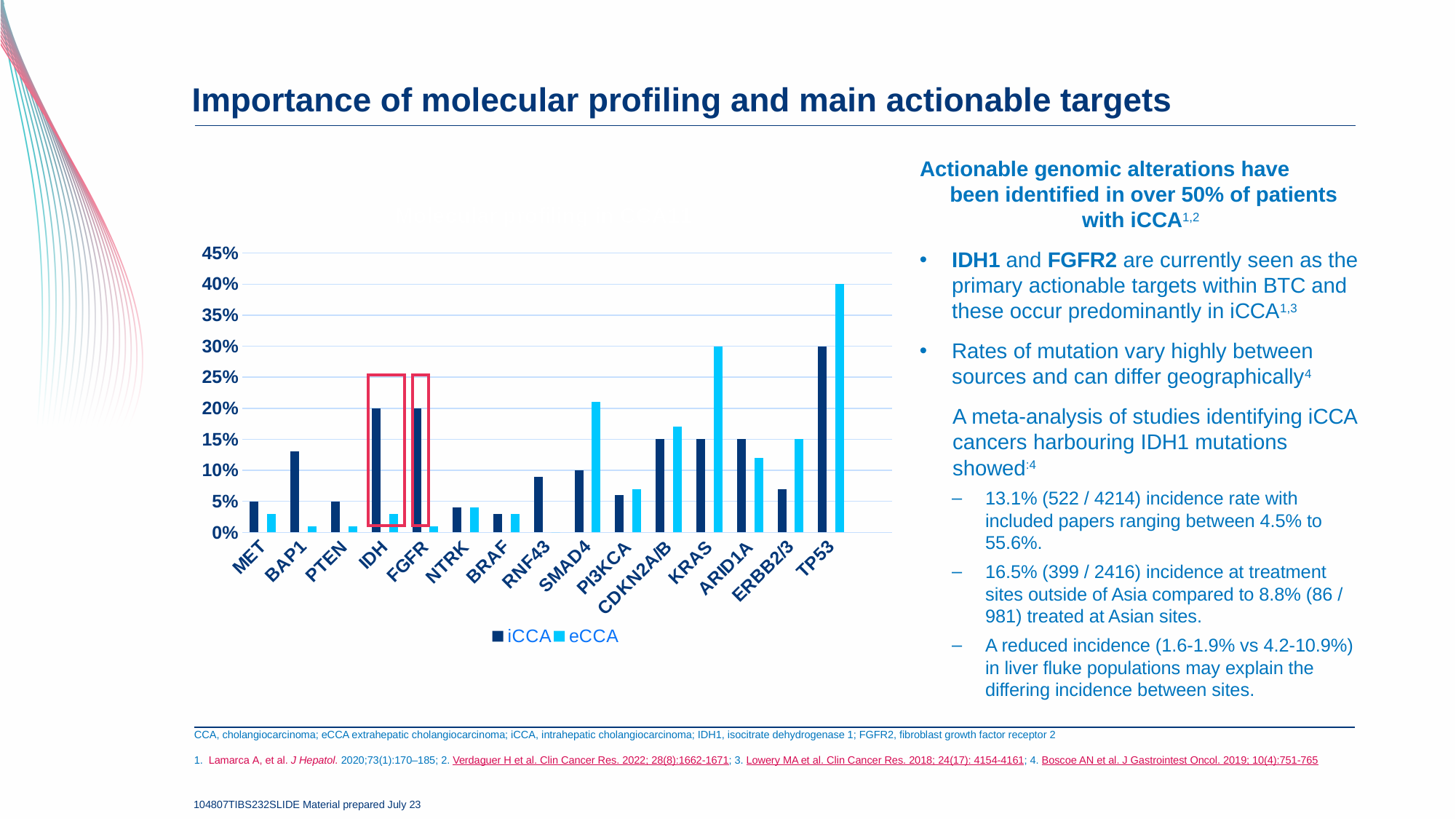
For TP53, which series has the larger value, iCCA or eCCA? eCCA For BAP1, which series has the larger value, iCCA or eCCA? iCCA What kind of chart is shown on the slide? Bar chart Is the iCCA value for BAP1 greater or less than 10%? greater What is the difference between the eCCA and iCCA values for TP53? 10% Which gene has the highest eCCA value? TP53 Which two genes on the chart are highlighted with red boxes? IDH and FGFR How many series does the chart legend list? 2 What is the iCCA value for IDH? 20% What is the eCCA value for TP53? 40% How many gene categories are shown on the x axis of the chart? 15 What is the eCCA value for KRAS? 30%